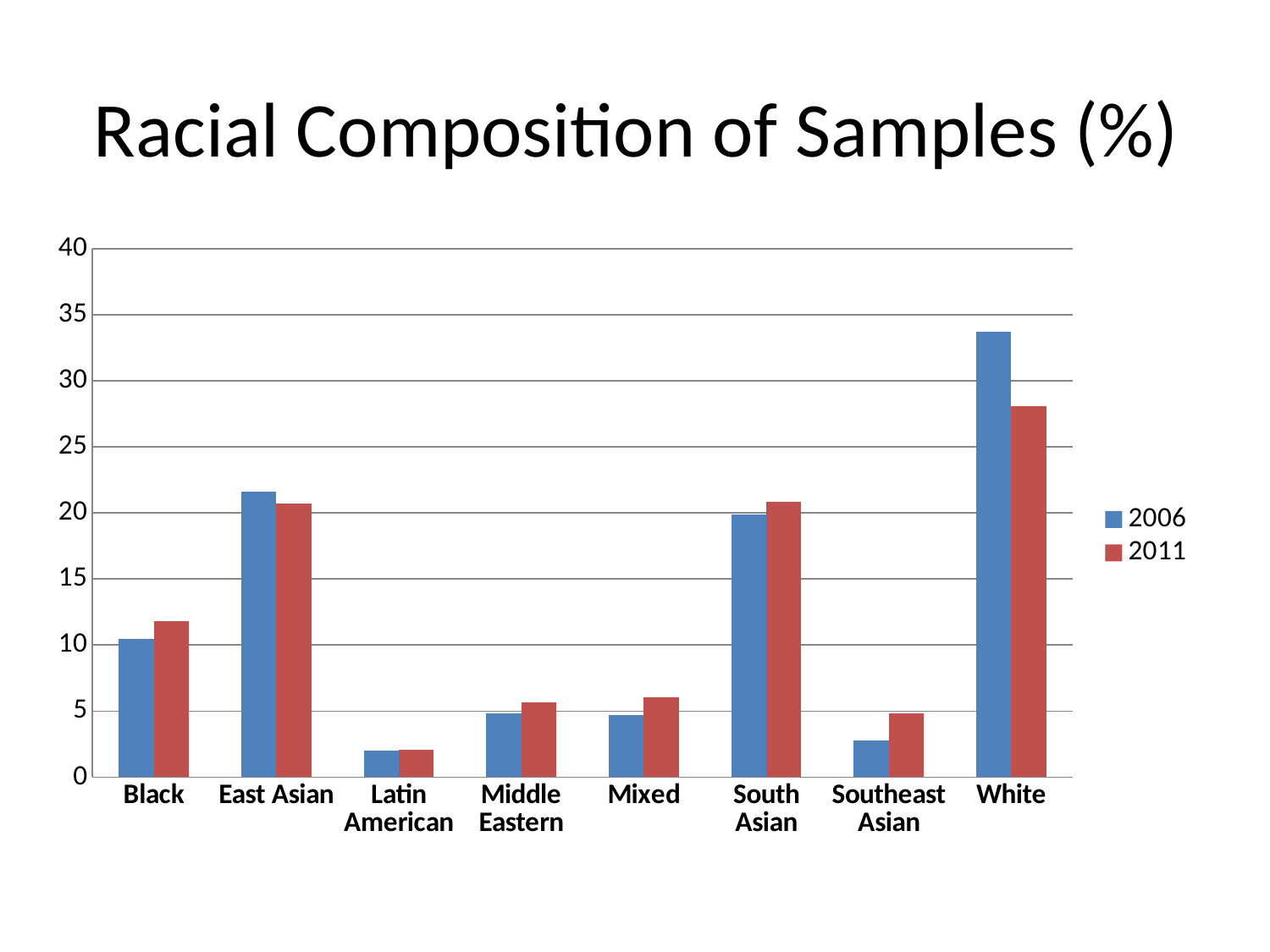
Is the value for White in 2006 greater or less than 30? greater For Southeast Asian, which year has the larger value, 2006 or 2011? 2011 Is the value for Southeast Asian in 2006 greater or less than 5? less How many racial categories are shown on the x axis? 8 What kind of chart is shown on the slide? bar chart What is the title of the chart? Racial Composition of Samples (%) How many series does the legend list? 2 Is the value for East Asian in 2006 greater or less than 20? greater Which category has the highest value for 2006? White For White, which year has the larger value, 2006 or 2011? 2006 Which category has the lowest value for 2011? Latin American